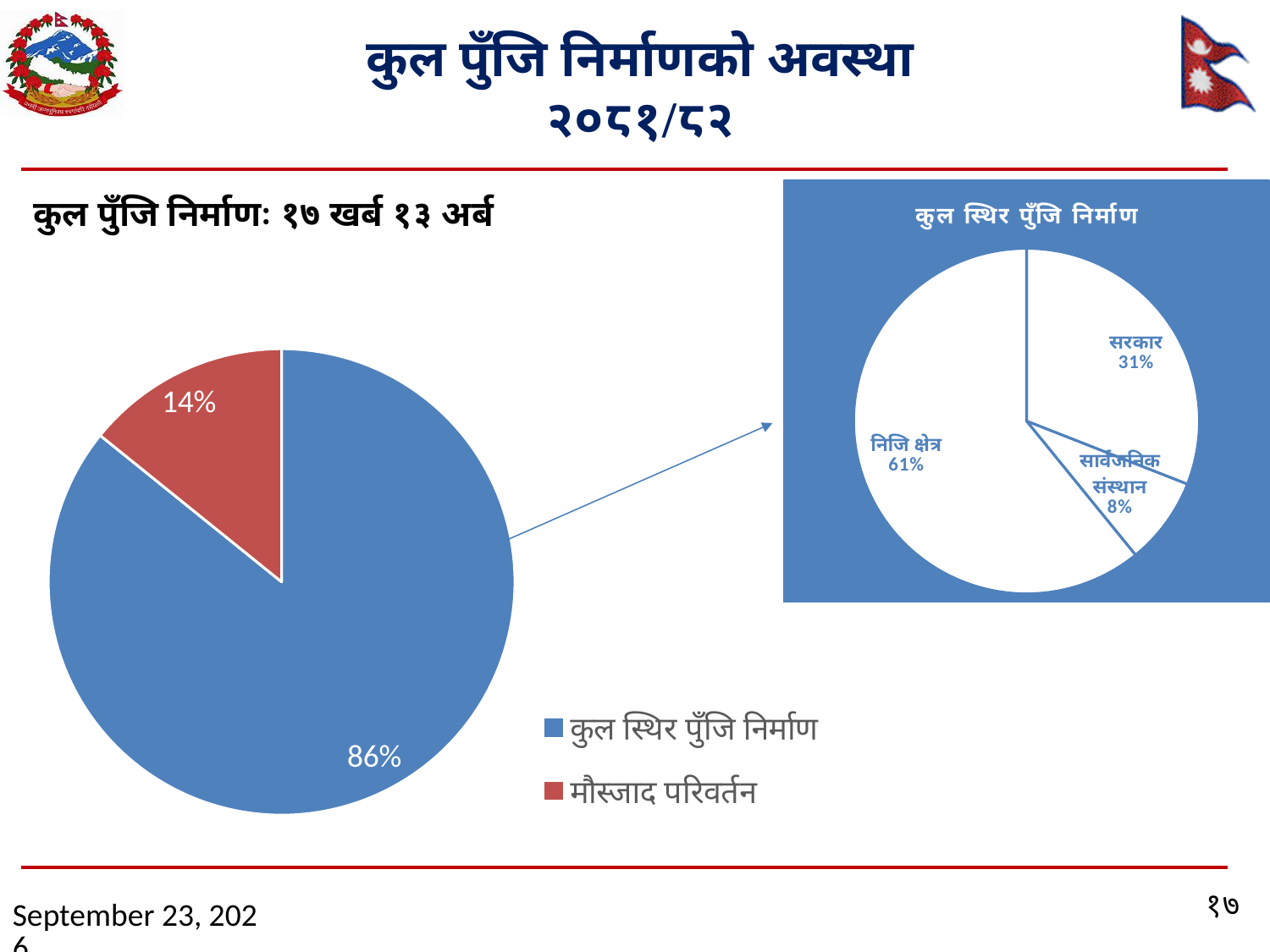
In the chart titled कुल स्थिर पुँजि निर्माण on the right, which is larger: सरकार or सार्वजनिक संस्थान? सरकार What type of chart is the large chart on the left of the slide? Pie chart In the large pie chart on the left, which slice is the largest? कुल स्थिर पुँजि निर्माण How many entries does the legend of the large pie chart on the left list? 2 In the chart titled कुल स्थिर पुँजि निर्माण on the right, which slice is the smallest? सार्वजनिक संस्थान In the large pie chart on the left, what share is labelled for कुल स्थिर पुँजि निर्माण? 86% In the large pie chart on the left, what share is labelled for मौस्जाद परिवर्तन? 14% In the large pie chart on the left, what is the difference in percentage points between the two slices? 72 In the chart titled कुल स्थिर पुँजि निर्माण on the right, what share is labelled for निजि क्षेत्र? 61% In the chart titled कुल स्थिर पुँजि निर्माण on the right, what is the difference in percentage points between निजि क्षेत्र and सरकार? 30 In the chart titled कुल स्थिर पुँजि निर्माण on the right, how many slices does the pie have? 3